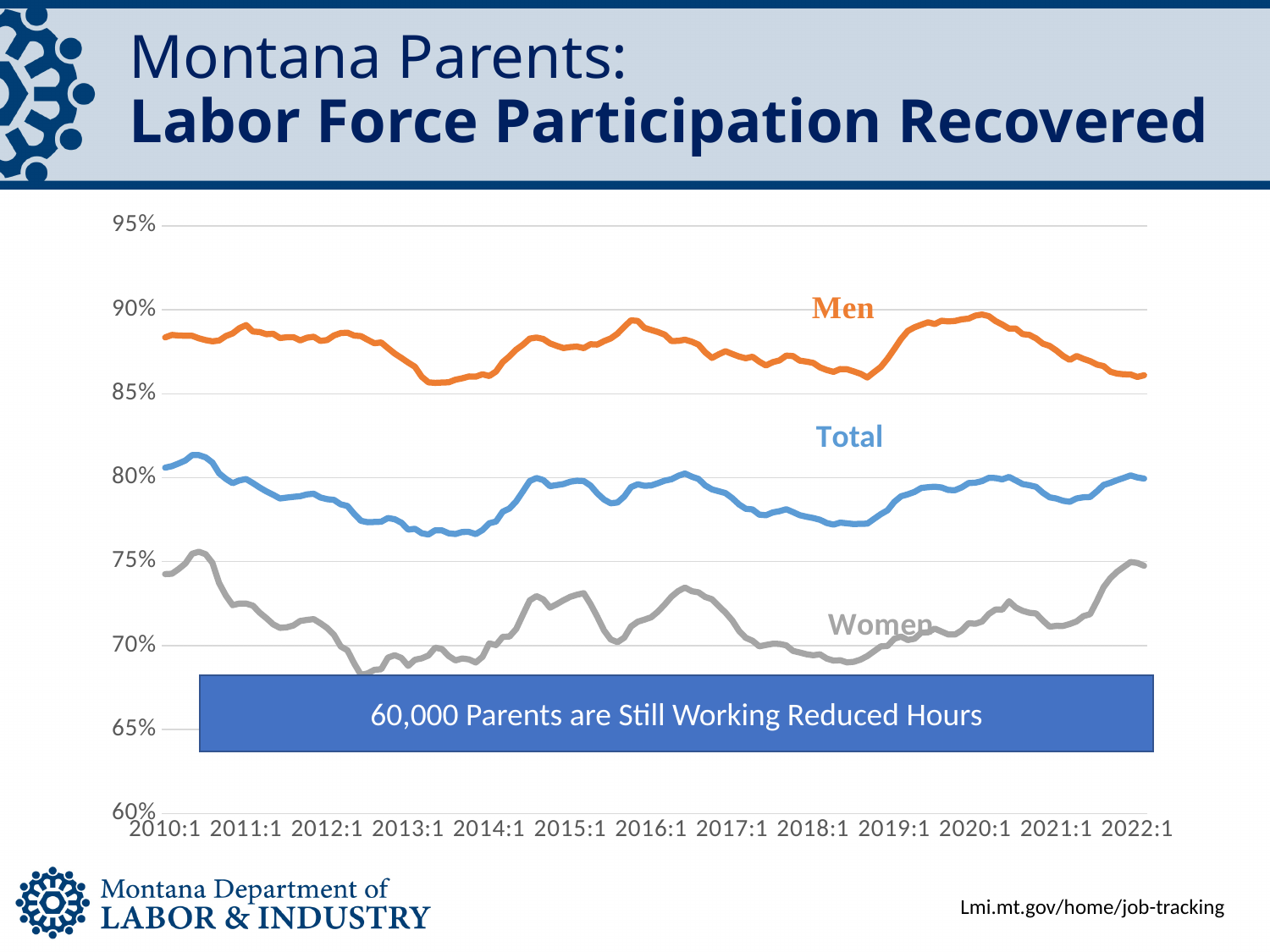
Does the Women series rise or fall between 2020:1 and 2022:1? rise Is the value for Women at 2022:1 greater or less than 70%? greater What colour is the line for Men? orange Which is larger at 2022:1, the value for Total or the value for Women? Total What is the title of the slide? Montana Parents: Labor Force Participation Recovered Which series has the highest labor force participation throughout the chart? Men Is the value for Men at 2022:1 greater or less than 85%? greater Is the value for Total at 2013:1 greater or less than 80%? less Which series has the lowest labor force participation throughout the chart? Women How many series are plotted on the chart? 3 What kind of chart is shown on the slide? line chart